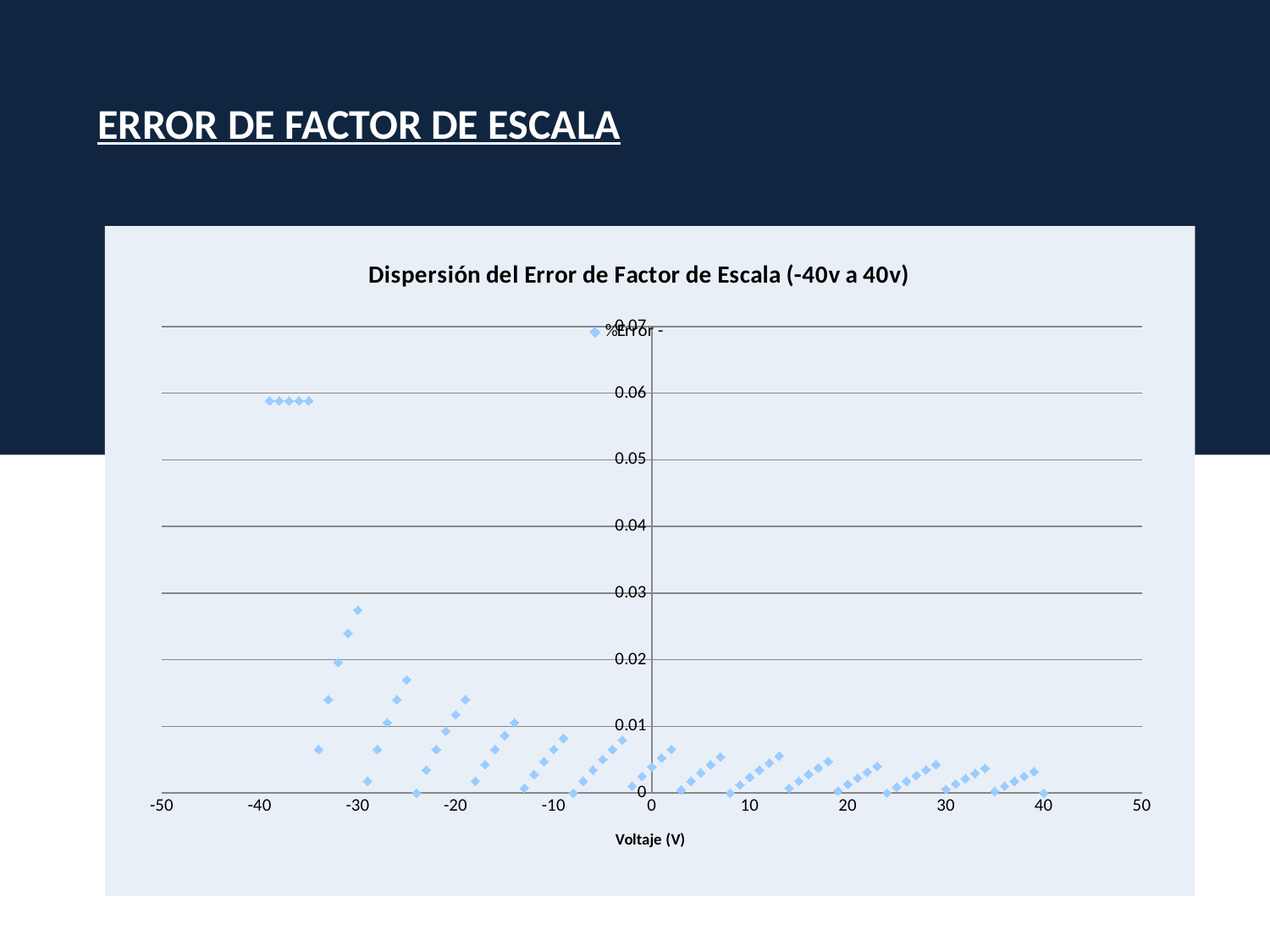
Is the value for the points near -38 V greater or less than 0.05? greater What is the title of the chart? Dispersión del Error de Factor de Escala (-40v a 40v) Which is larger, the value at -30 V or the value at 30 V? -30 V How many series does the legend list? 1 What is the label of the horizontal axis? Voltaje (V) Is the value for the point at 20 V greater or less than 0.01? less What kind of chart is shown on the slide? Scatter chart Is the value for the point at -30 V greater or less than 0.02? greater Are the highest plotted values found on the negative or the positive side of the voltage axis? negative What is the highest tick value shown on the vertical axis? 0.07 Overall, do the plotted values tend to decrease or increase as voltage goes from -40 V to 40 V? decrease